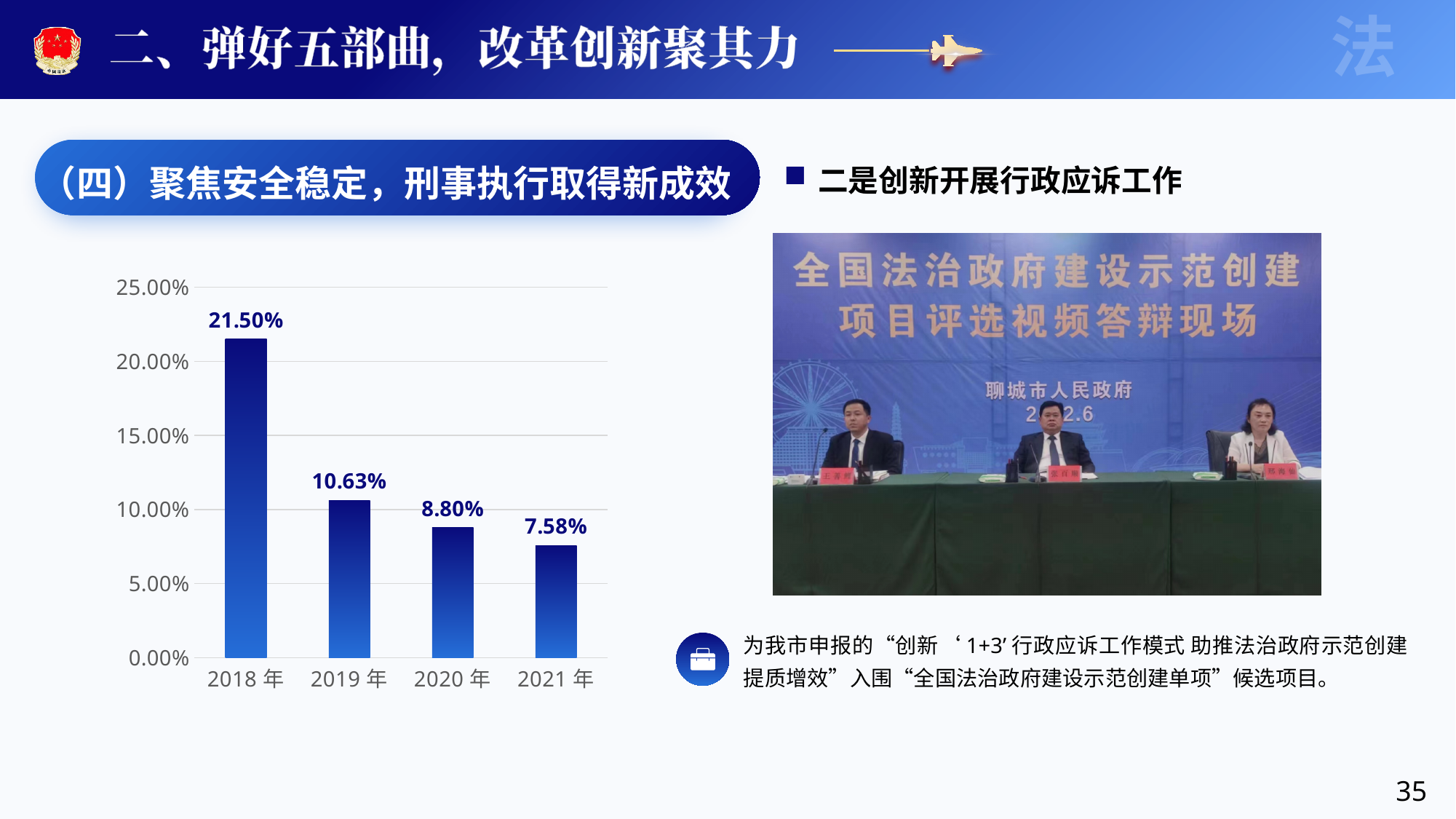
Which is larger, the value for 2019年 or the value for 2020年? 2019年 What is the difference between the values for 2018年 and 2019年? 10.87% What is the value for 2018年? 21.50% Which year has the lowest value? 2021年 What is the difference between the values for 2020年 and 2021年? 1.22% Which year has the highest value? 2018年 What is the value for 2020年? 8.80% Do the values rise or fall from 2018年 to 2021年? Fall How many years are shown on the chart? 4 What is the value for 2019年? 10.63% What kind of chart is shown on the slide? Bar chart What is the value for 2021年? 7.58%